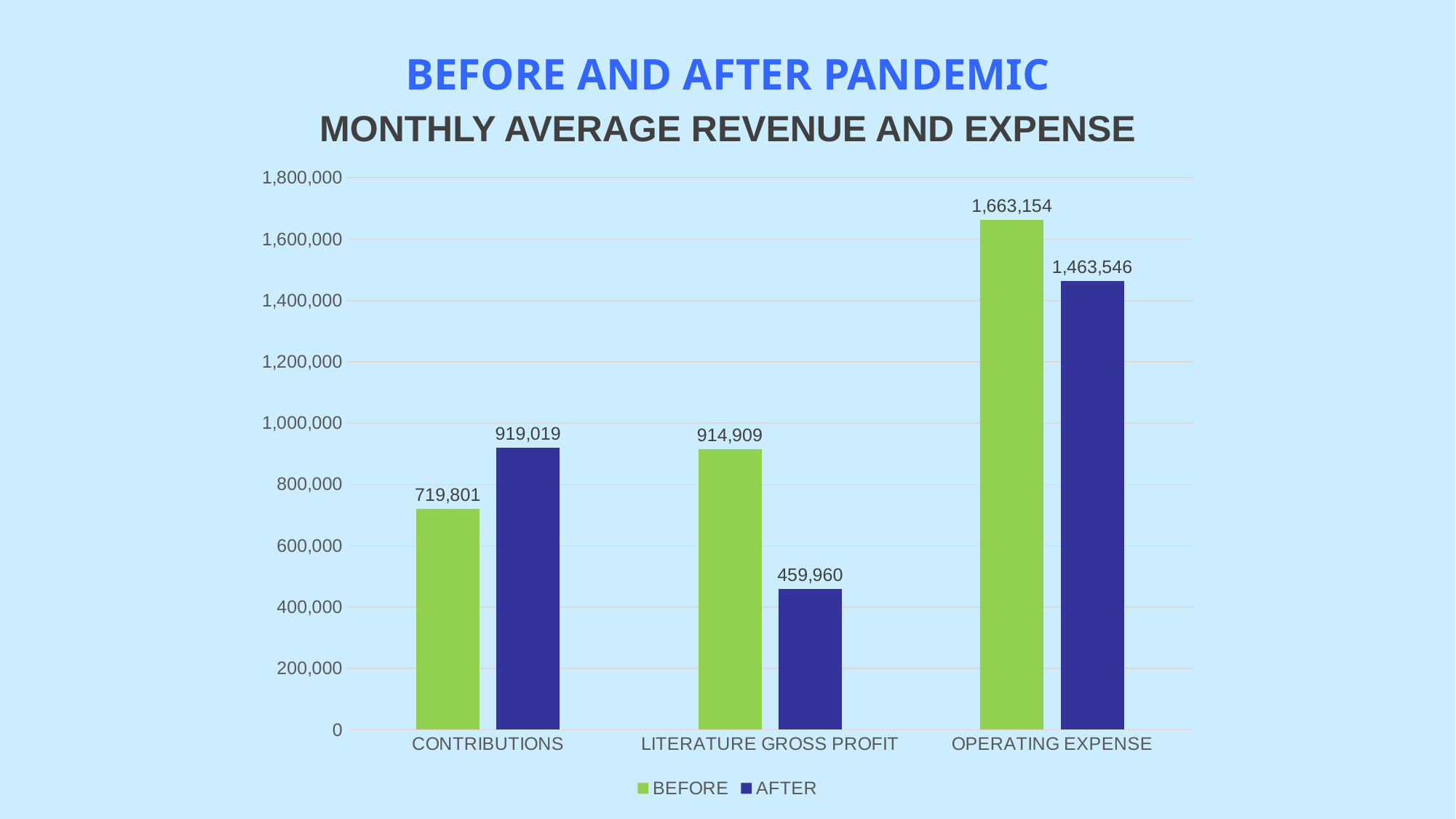
What is the BEFORE value for OPERATING EXPENSE? 1,663,154 What is the AFTER value for LITERATURE GROSS PROFIT? 459,960 What is the difference between the BEFORE and AFTER values for LITERATURE GROSS PROFIT? 454,949 What is the BEFORE value for CONTRIBUTIONS? 719,801 How many categories are shown on the x axis? 3 What is the AFTER value for OPERATING EXPENSE? 1,463,546 How many series does the legend list? 2 Which category has the lowest BEFORE value? CONTRIBUTIONS For CONTRIBUTIONS, which is larger, the BEFORE value or the AFTER value? AFTER What is the difference between the AFTER and BEFORE values for CONTRIBUTIONS? 199,218 Which category has the highest AFTER value? OPERATING EXPENSE What kind of chart is shown on the slide? Bar chart